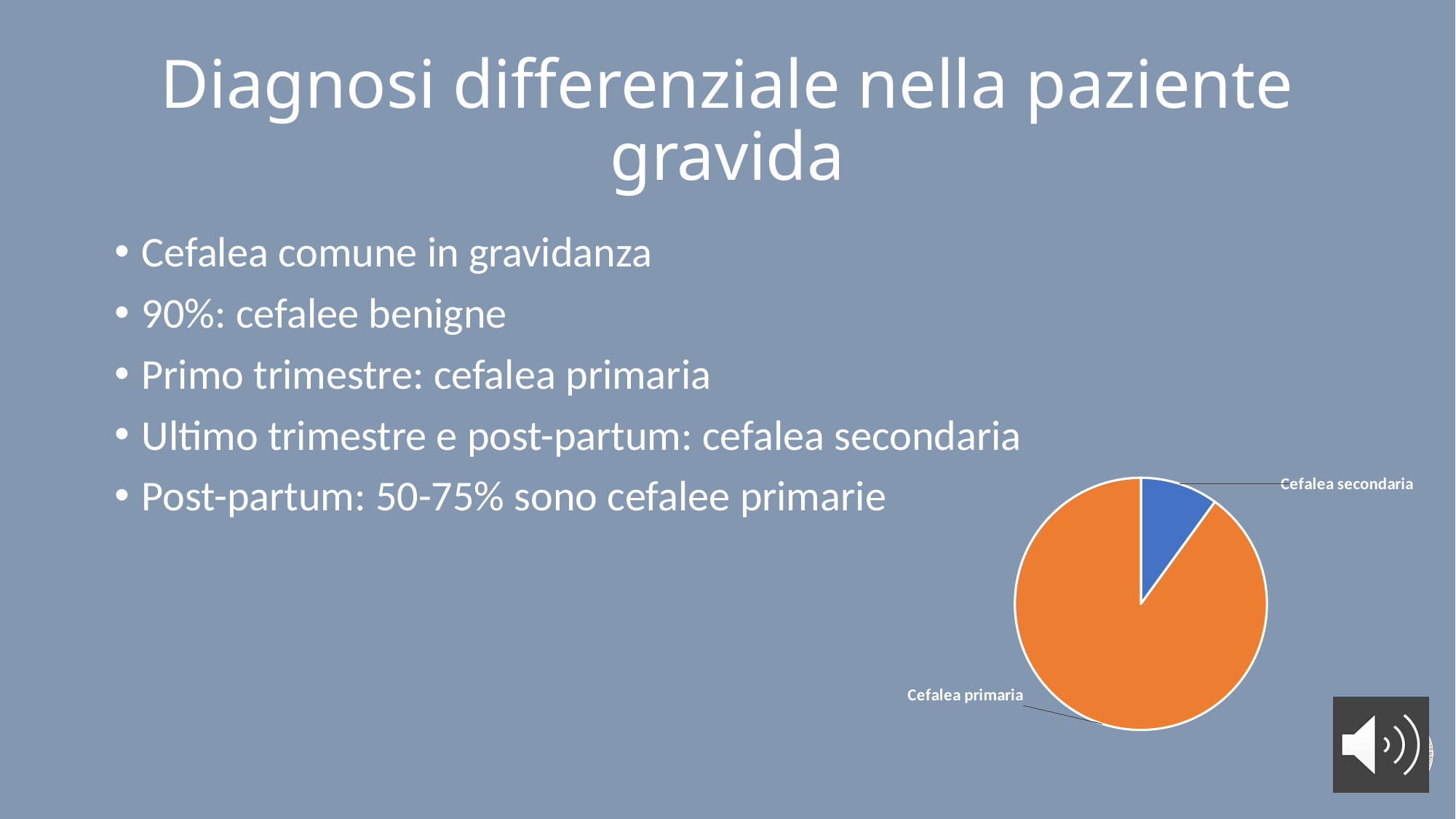
Which slice of the pie chart is the smallest? Cefalea secondaria What kind of chart is shown on the slide? pie chart What colour is the Cefalea secondaria slice in the pie chart? blue Which is larger in the pie chart, Cefalea primaria or Cefalea secondaria? Cefalea primaria Does the Cefalea primaria slice take up more or less than half of the pie chart? more How many slices does the pie chart have? 2 What colour is the Cefalea primaria slice in the pie chart? orange Which slice of the pie chart is the largest? Cefalea primaria